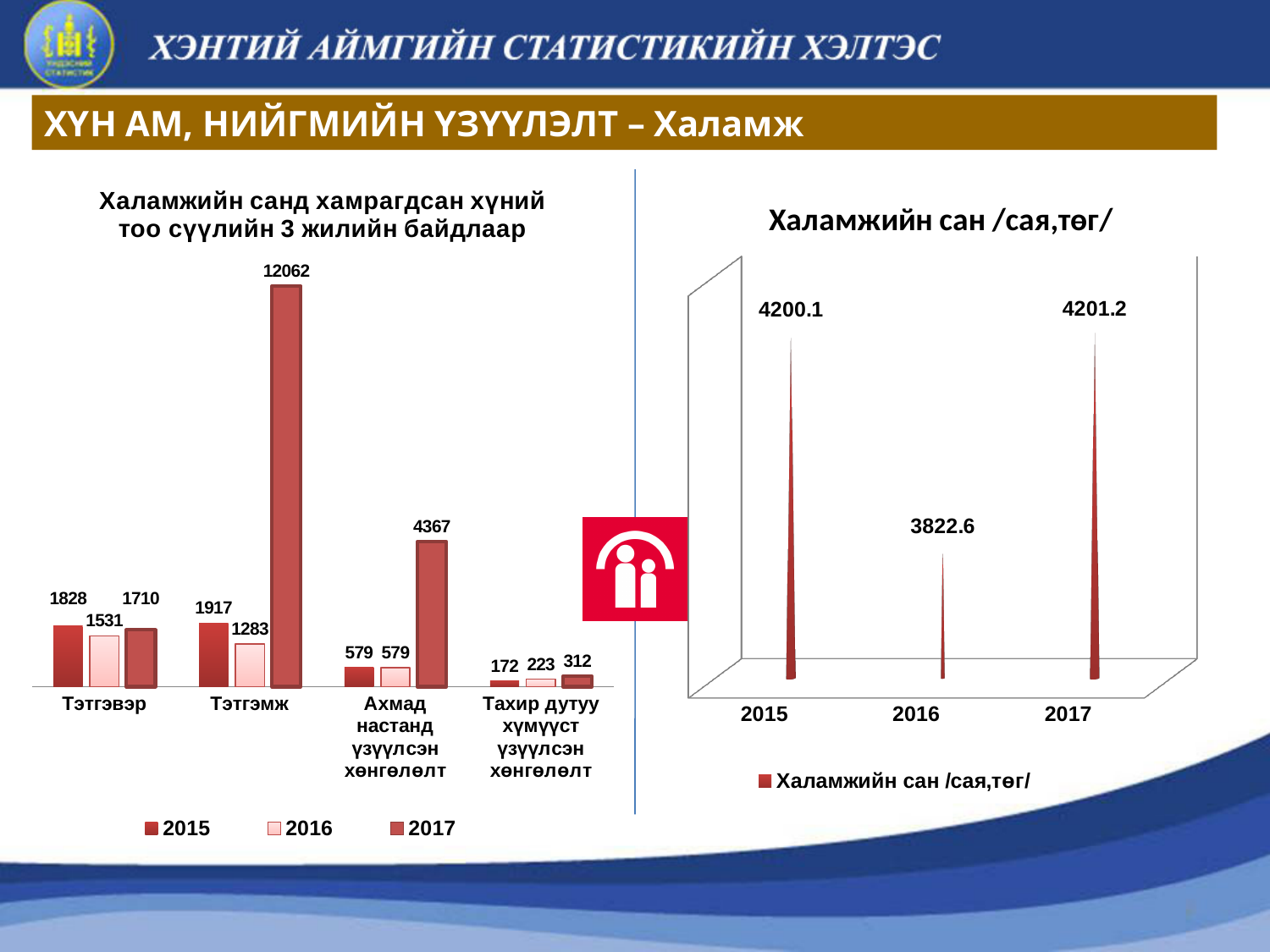
What kind of chart is the left chart? bar chart In the right chart 'Халамжийн сан /сая,төг/', what is the value for 2016? 3822.6 In the left chart 'Халамжийн санд хамрагдсан хүний тоо сүүлийн 3 жилийн байдлаар', what is the value for Тэтгэмж in 2017? 12062 In the right chart 'Халамжийн сан /сая,төг/', which year has the lowest value? 2016 In the left chart, which category has the lowest value in 2015? Тахир дутуу хүмүүст үзүүлсэн хөнгөлөлт In the left chart, what is the difference between the 2017 and 2015 values for Тэтгэмж? 10145 How many series does the legend of the left chart list? 3 In the left chart, which is larger for Тэтгэвэр: the 2015 value or the 2016 value? 2015 In the right chart 'Халамжийн сан /сая,төг/', what is the difference between the 2017 and 2016 values? 378.6 In the left chart, what is the value for Тэтгэвэр in 2016? 1531 In the left chart, what is the 2017 value for Ахмад настанд үзүүлсэн хөнгөлөлт? 4367 In the left chart, which category has the highest value in 2017? Тэтгэмж